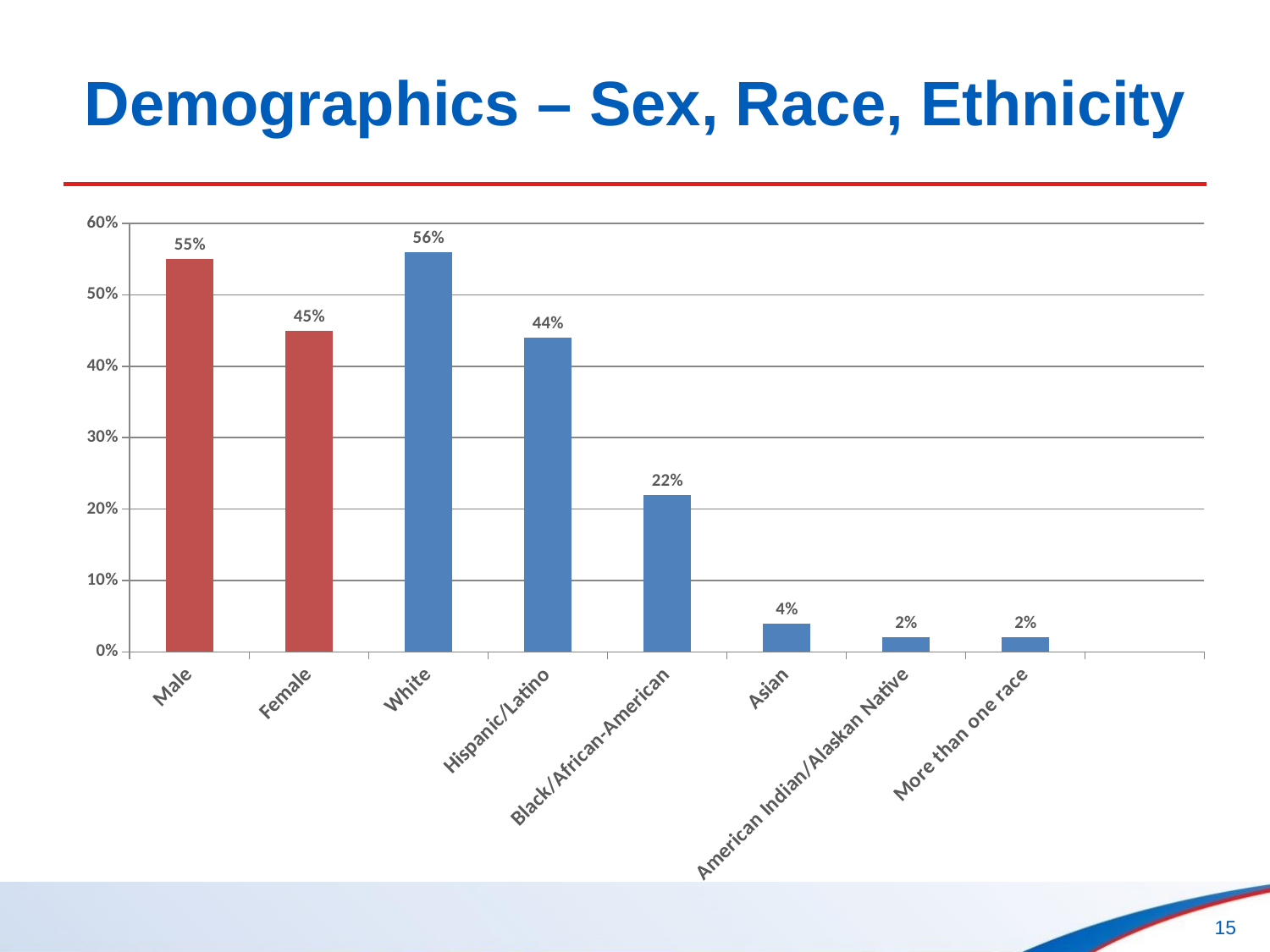
Which is larger, the value for Black/African-American or the value for Asian? Black/African-American What is the value for Asian? 4% What is the difference between the values for Male and Female? 10% What is the difference between the values for White and Hispanic/Latino? 12% What is the value for Black/African-American? 22% What kind of chart is shown on the slide? bar chart How many categories are shown on the x axis? 8 What is the value for Hispanic/Latino? 44% What colour are the Male and Female bars? red Which category has the highest value? White What is the value for Male? 55% Is the value for Black/African-American greater or less than 30%? less